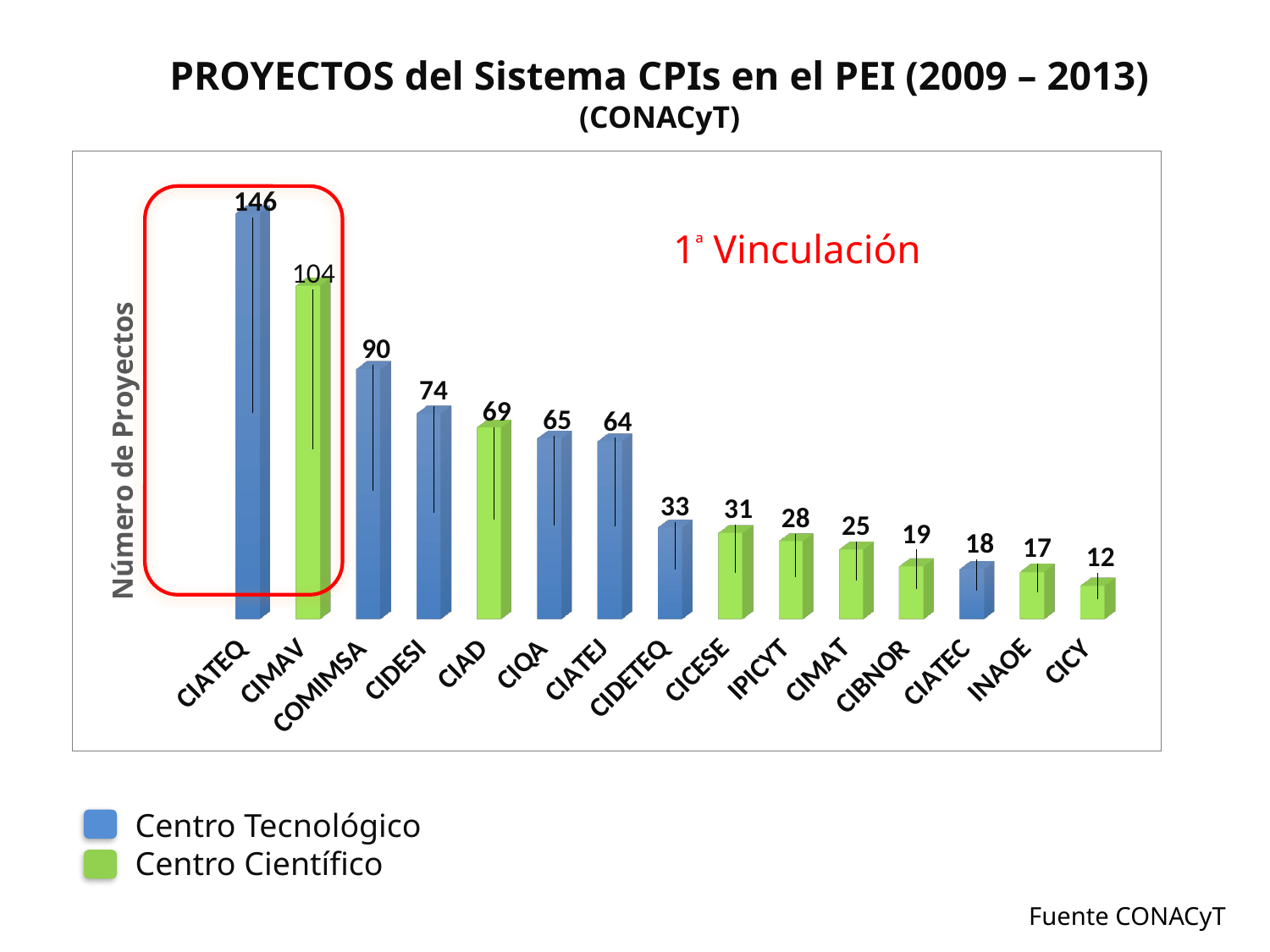
What is the number of projects for CIATEQ? 146 How many centers are shown on the x axis of the chart? 15 How many series does the legend list? 2 Which center has the highest number of projects? CIATEQ What is the difference in number of projects between CIATEQ and CIMAV? 42 Do the values rise or fall from left to right along the x axis? Fall Which center has the lowest number of projects? CICY What is the number of projects for CIMAV? 104 Which legend entry is shown in green? Centro Científico What kind of chart is shown on the slide? Bar chart What is the number of projects for CIDETEQ? 33 Which has more projects, COMIMSA or CIDESI? COMIMSA